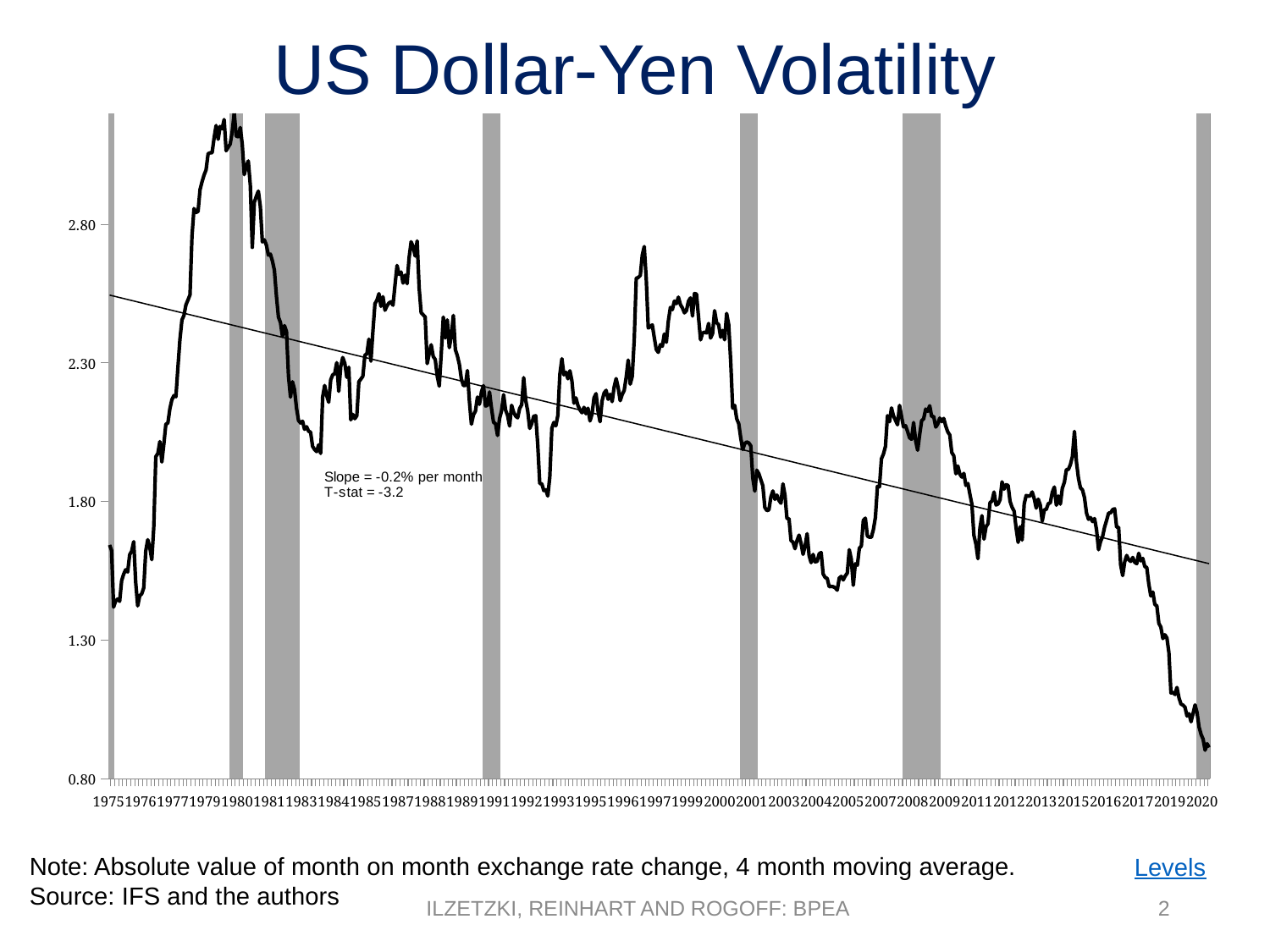
In which year does the series reach its lowest value? 2020 What is the title of the chart? US Dollar-Yen Volatility What T-stat is printed on the chart? -3.2 What slope is printed on the chart for the trend line? -0.2% per month Is the volatility value around 2008 greater or less than 1.80? greater Is the volatility value at the end of the series in 2020 greater or less than 1.30? less Do the volatility values generally rise or fall from 1975 to 2020 according to the fitted trend line? fall Is the volatility value around 2004 greater or less than 1.80? less What kind of chart is shown on the slide? line chart Which is higher, the volatility around 1979 or the volatility in 2020? 1979